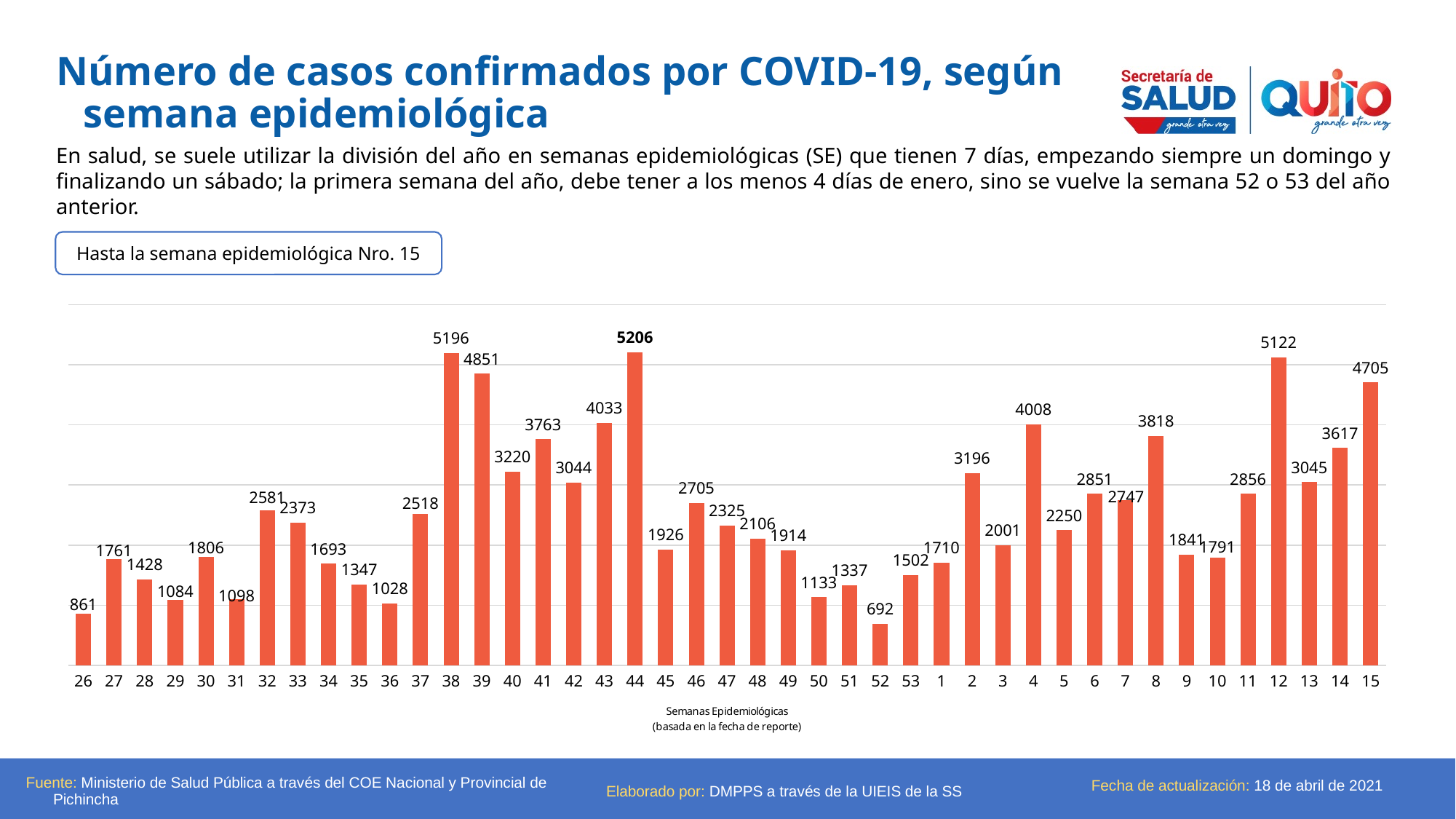
What is the difference between the values for week 44 and week 38? 10 Which epidemiological week has the lowest number of confirmed cases? 52 Which has a larger value, week 4 or week 8? week 4 What is the difference between the values for week 15 and week 14? 1088 What is the value for epidemiological week 52? 692 Which has a larger value, week 12 or week 13? week 12 How many epidemiological weeks are plotted on the chart? 43 Which epidemiological week has the highest number of confirmed cases? 44 What kind of chart is shown on the slide? bar chart How many confirmed COVID-19 cases are shown for epidemiological week 38? 5196 What is the value for epidemiological week 15? 4705